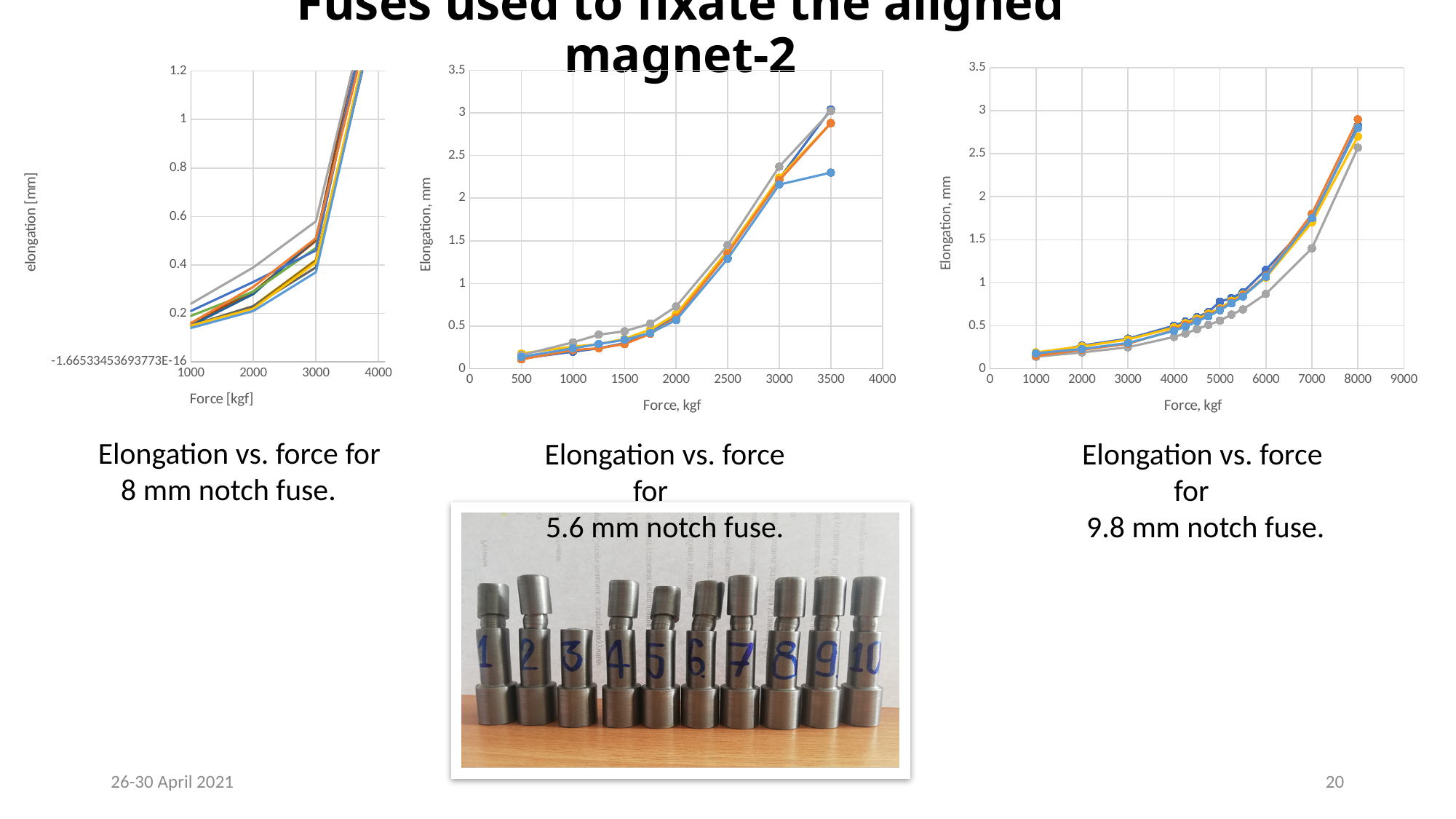
In the middle chart (5.6 mm notch fuse), is the lowest elongation value at 3500 kgf greater or less than 2? greater In the middle chart (5.6 mm notch fuse), are the elongation values at 2000 kgf greater or less than 1? less In the left chart (8 mm notch fuse), are the elongation values at 3000 kgf greater or less than 0.2? greater In the middle chart (5.6 mm notch fuse), do the elongation values rise or fall as force increases? rise What kind of chart is the 'Elongation vs. force for 8 mm notch fuse' chart on the left? line chart What is the x-axis label of the right chart (9.8 mm notch fuse)? Force, kgf In the right chart (9.8 mm notch fuse), do the elongation values rise or fall as force increases? rise In the middle chart (5.6 mm notch fuse), how many force values are plotted along each line? 9 What is the y-axis label of the left chart (8 mm notch fuse)? elongation [mm]